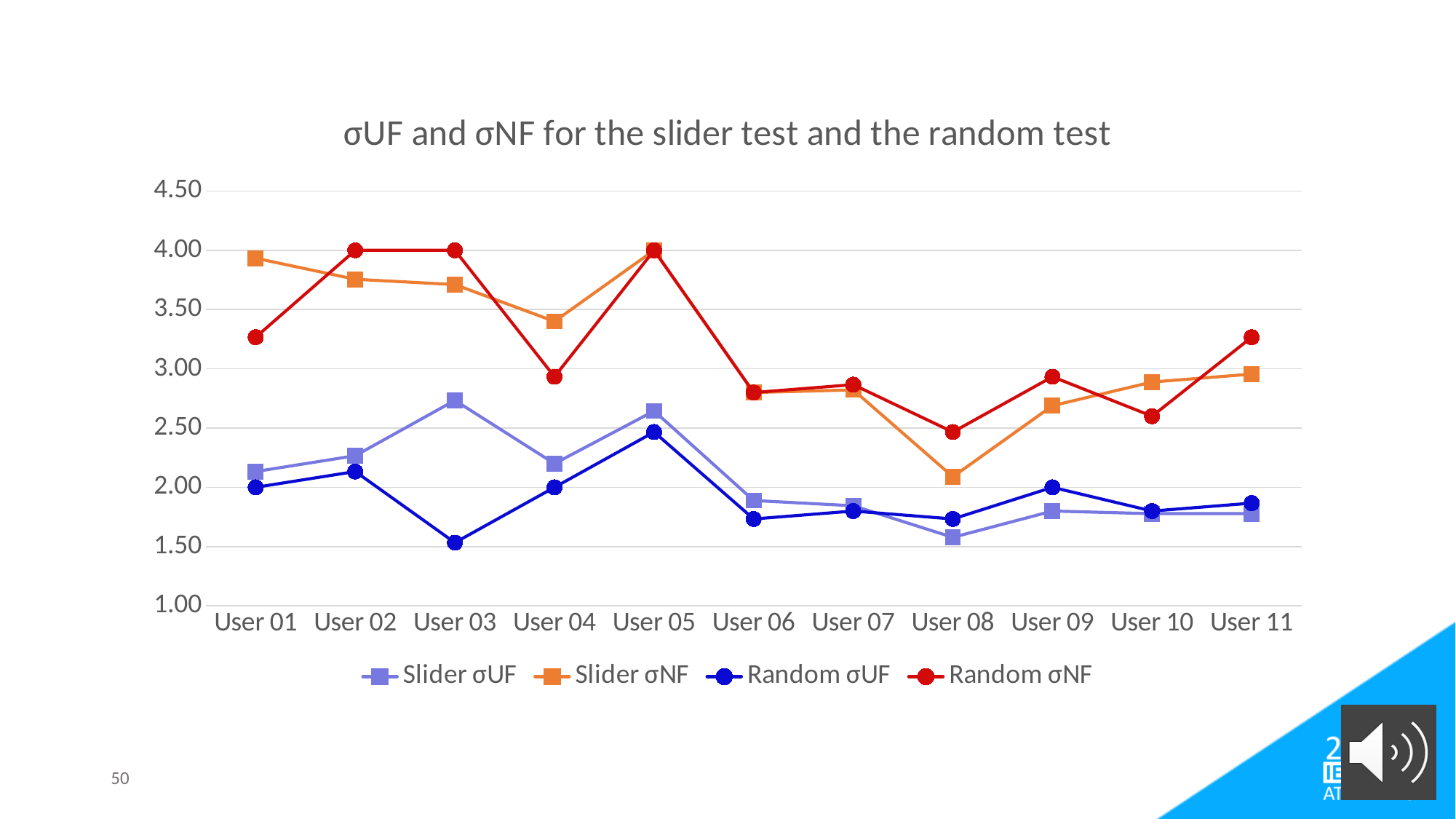
How many users are plotted along the x axis? 11 What is the Random σNF value for User 02? 4.00 What is the title of the chart? σUF and σNF for the slider test and the random test What kind of chart is shown on the slide? line chart Does Slider σNF rise or fall from User 01 to User 04? fall How many series does the legend list? 4 For which user is Slider σNF lowest? User 08 For which user is Random σUF lowest? User 03 Is the Slider σNF value for User 01 greater or less than 3.50? greater What is the Random σUF value for User 01? 2.00 Is the Random σUF value for User 03 greater or less than 2.00? less For User 03, which is larger: Random σNF or Slider σNF? Random σNF